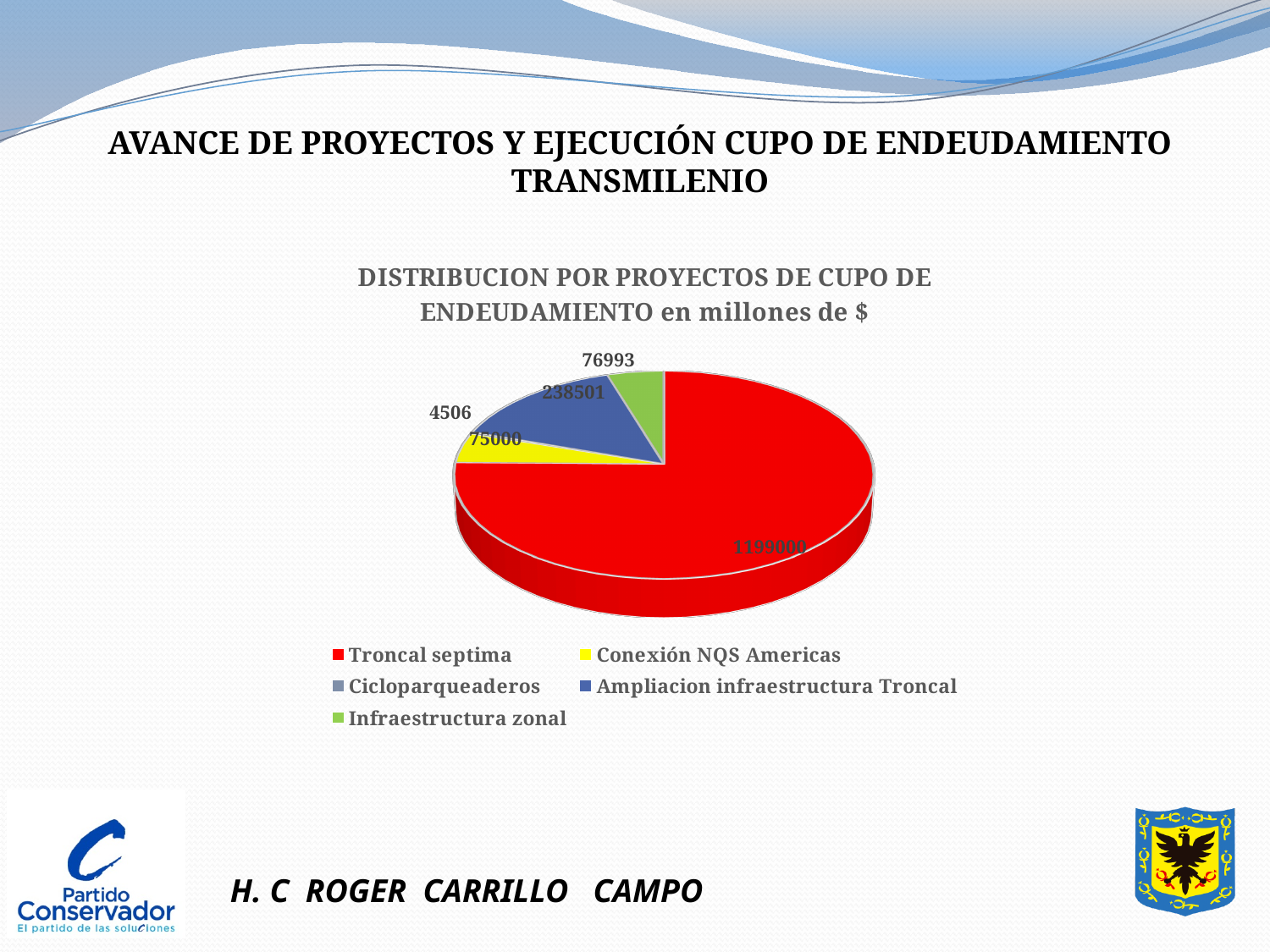
Which is larger, the value for Troncal septima or the value for Ampliacion infraestructura Troncal? Troncal septima What is the value for Ampliacion infraestructura Troncal? 238501 What is the value for Conexión NQS Americas? 75000 What is the value for Troncal septima? 1199000 What is the value for Cicloparqueaderos? 4506 How many categories does the legend list? 5 What type of chart is shown on the slide? Pie chart What is the difference between the values for Ampliacion infraestructura Troncal and Infraestructura zonal? 161508 What colour is the slice for Troncal septima? Red Which project has the smallest slice of the pie? Cicloparqueaderos Which project has the largest slice of the pie? Troncal septima What is the value for Infraestructura zonal? 76993